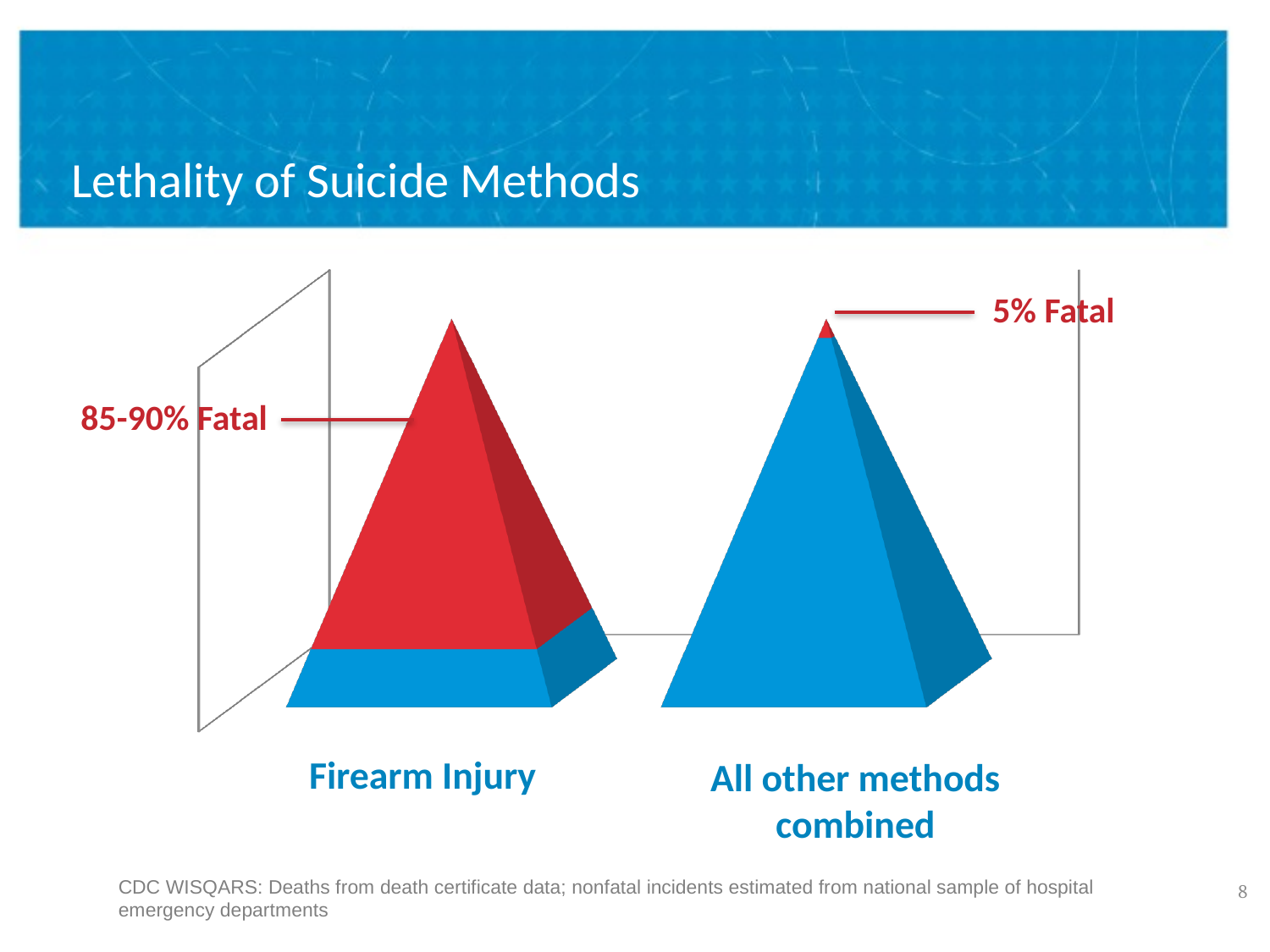
What percentage of Firearm Injury cases are labelled as fatal? 85-90% Fatal What are the two category labels shown beneath the pyramids? Firearm Injury; All other methods combined What is the title of the chart on the slide? Lethality of Suicide Methods What colour represents the fatal portion of each pyramid? Red What kind of chart is shown on the slide? Pyramid chart How many categories are shown in the chart? 2 Which category has the higher fatality percentage? Firearm Injury Which category has the lower fatality percentage? All other methods combined Is the fatality percentage larger for Firearm Injury or for All other methods combined? Firearm Injury What percentage of All other methods combined is labelled as fatal? 5% Fatal